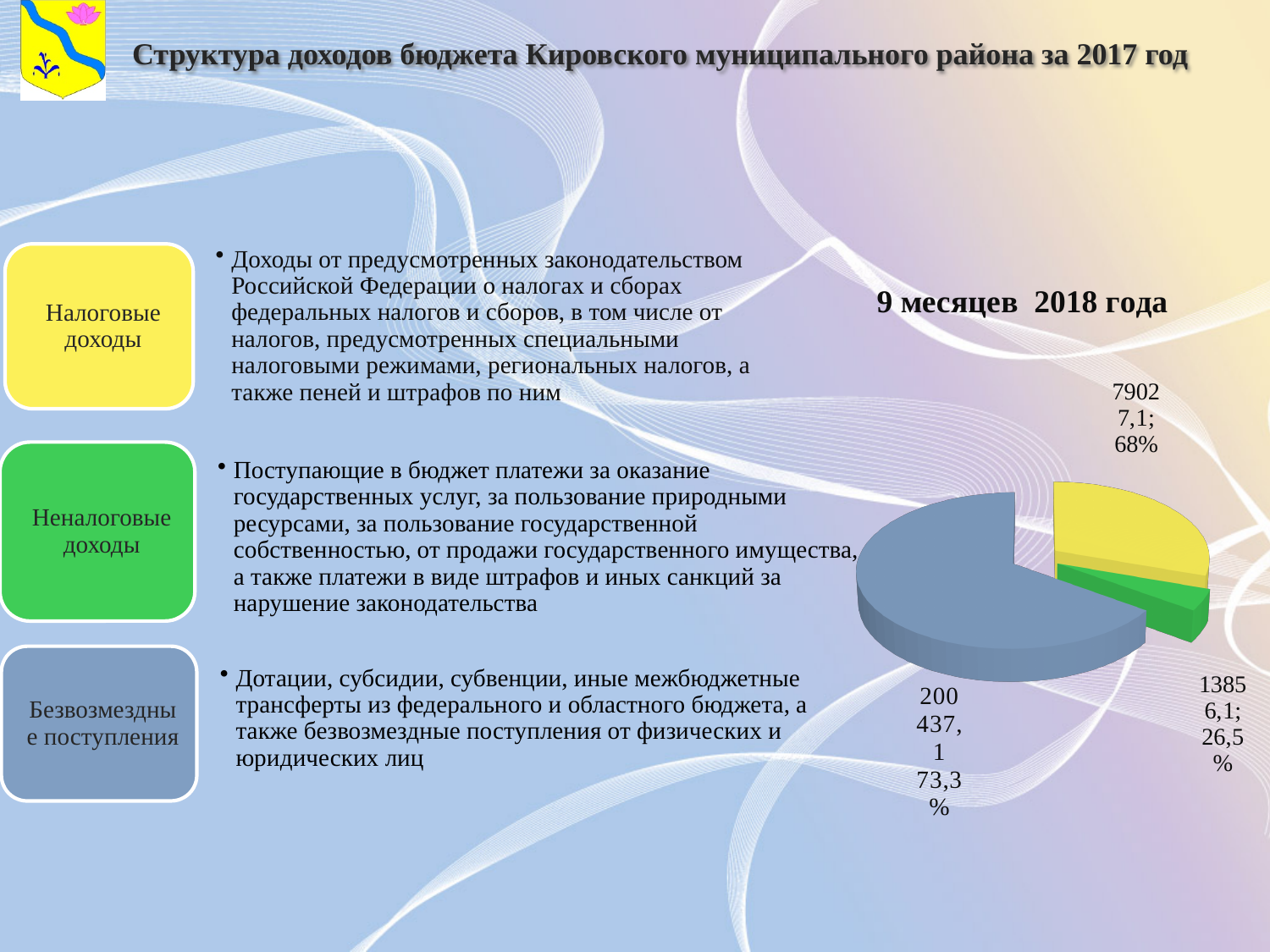
Which slice of the pie chart is the smallest? the green slice (Неналоговые доходы) What colour is the largest slice of the pie chart? blue How many slices does the pie chart have? 3 What data label is printed next to the yellow slice of the pie chart? 79027,1; 68% What kind of chart is shown on the slide? pie chart What data label is printed next to the green slice of the pie chart? 13856,1; 26,5% Which slice of the pie chart is the largest? the blue slice (Безвозмездные поступления) What percentage is printed on the label of the blue slice? 73,3% What is the title of the pie chart? 9 месяцев 2018 года Which slice is larger, the yellow one or the green one? the yellow one What data label is printed next to the blue slice of the pie chart? 200437,1 73,3%